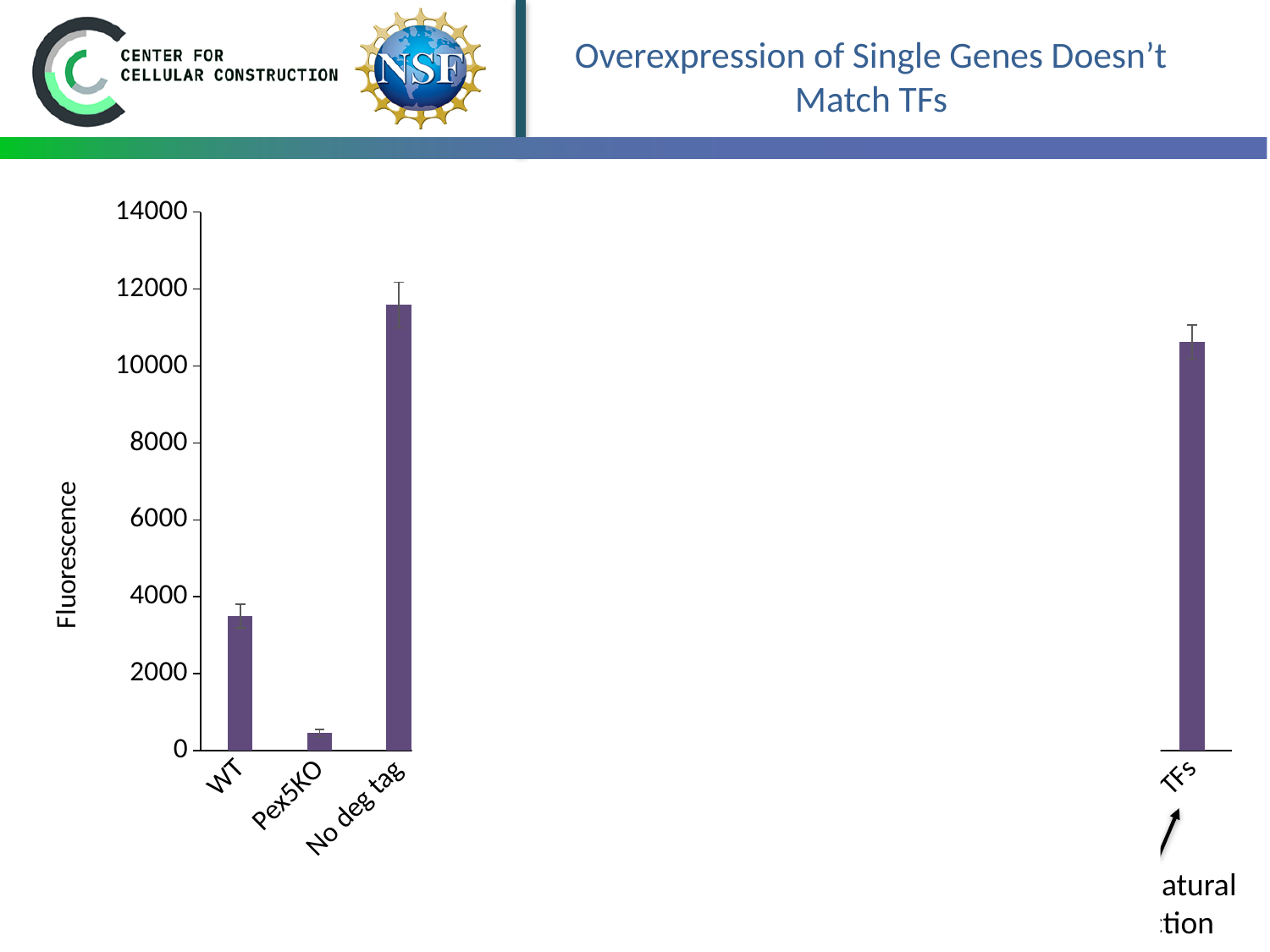
Which category has the lowest fluorescence? Pex5KO Which category has the highest fluorescence? No deg tag What kind of chart is shown on the slide? bar chart Which has a higher fluorescence, No deg tag or TFs? No deg tag Is the fluorescence value for TFs greater or less than 12000? less Is the fluorescence value for WT greater or less than 4000? less Which has a higher fluorescence, WT or TFs? TFs What is the label of the vertical axis? Fluorescence Is the fluorescence value for WT greater or less than 2000? greater How many labeled bars are visible on the chart? 4